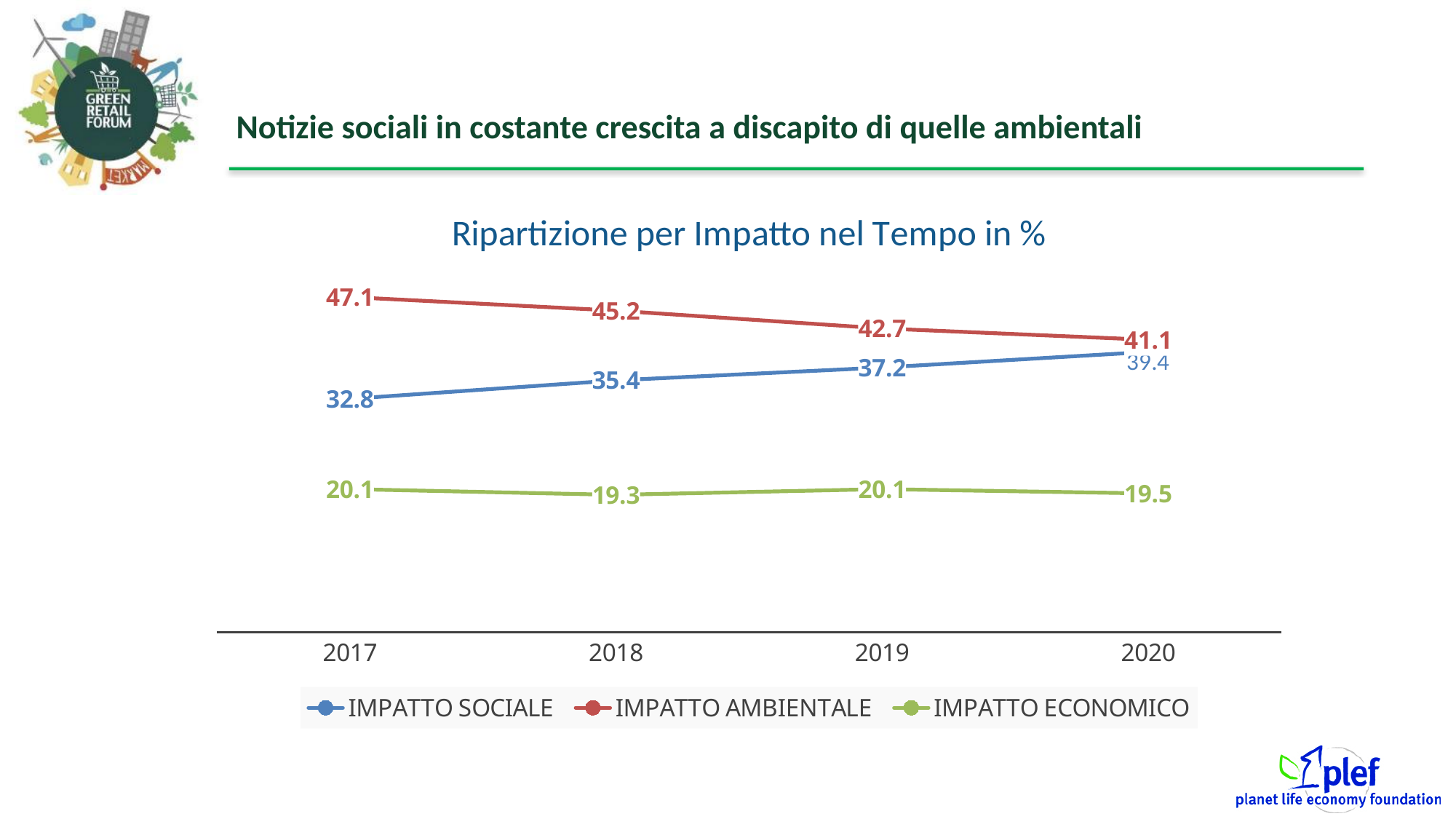
Does IMPATTO AMBIENTALE rise or fall from 2017 to 2020? fall In which year is IMPATTO AMBIENTALE highest? 2017 What kind of chart is this? line chart What is the difference between IMPATTO AMBIENTALE and IMPATTO SOCIALE in 2020? 1.7 What is the value for IMPATTO AMBIENTALE in 2017? 47.1 How many years are shown on the x axis? 4 What is the value for IMPATTO SOCIALE in 2020? 39.4 What is the value for IMPATTO SOCIALE in 2019? 37.2 Which is larger in 2018: IMPATTO AMBIENTALE or IMPATTO SOCIALE? IMPATTO AMBIENTALE What is the value for IMPATTO ECONOMICO in 2018? 19.3 How many series does the legend list? 3 In which year is IMPATTO SOCIALE lowest? 2017